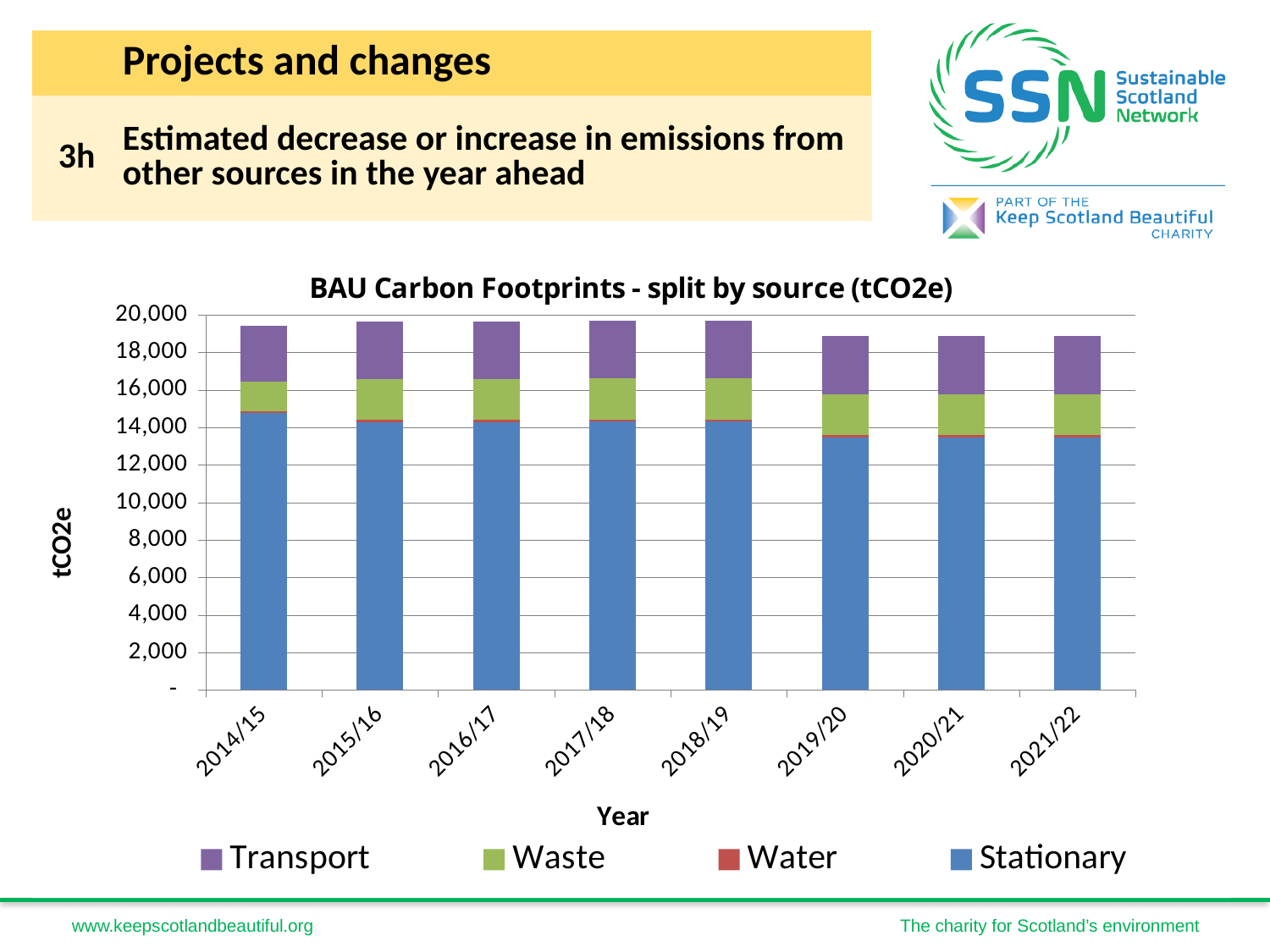
Which series is shown in blue in the chart? Stationary What kind of chart is shown on the slide? Stacked bar chart Is the Stationary value for 2019/20 greater or less than 14,000? less Does the Stationary value rise or fall from 2014/15 to 2021/22? Fall Is the total stacked value for 2021/22 greater or less than 20,000? less Is the Stationary value for 2014/15 greater or less than 14,000? greater Which year has the larger total stacked value, 2015/16 or 2019/20? 2015/16 How many series does the chart legend list? 4 What is the title of the chart? BAU Carbon Footprints - split by source (tCO2e) How many years are shown on the x axis of the chart? 8 Which series forms the smallest segment in each stacked bar? Water